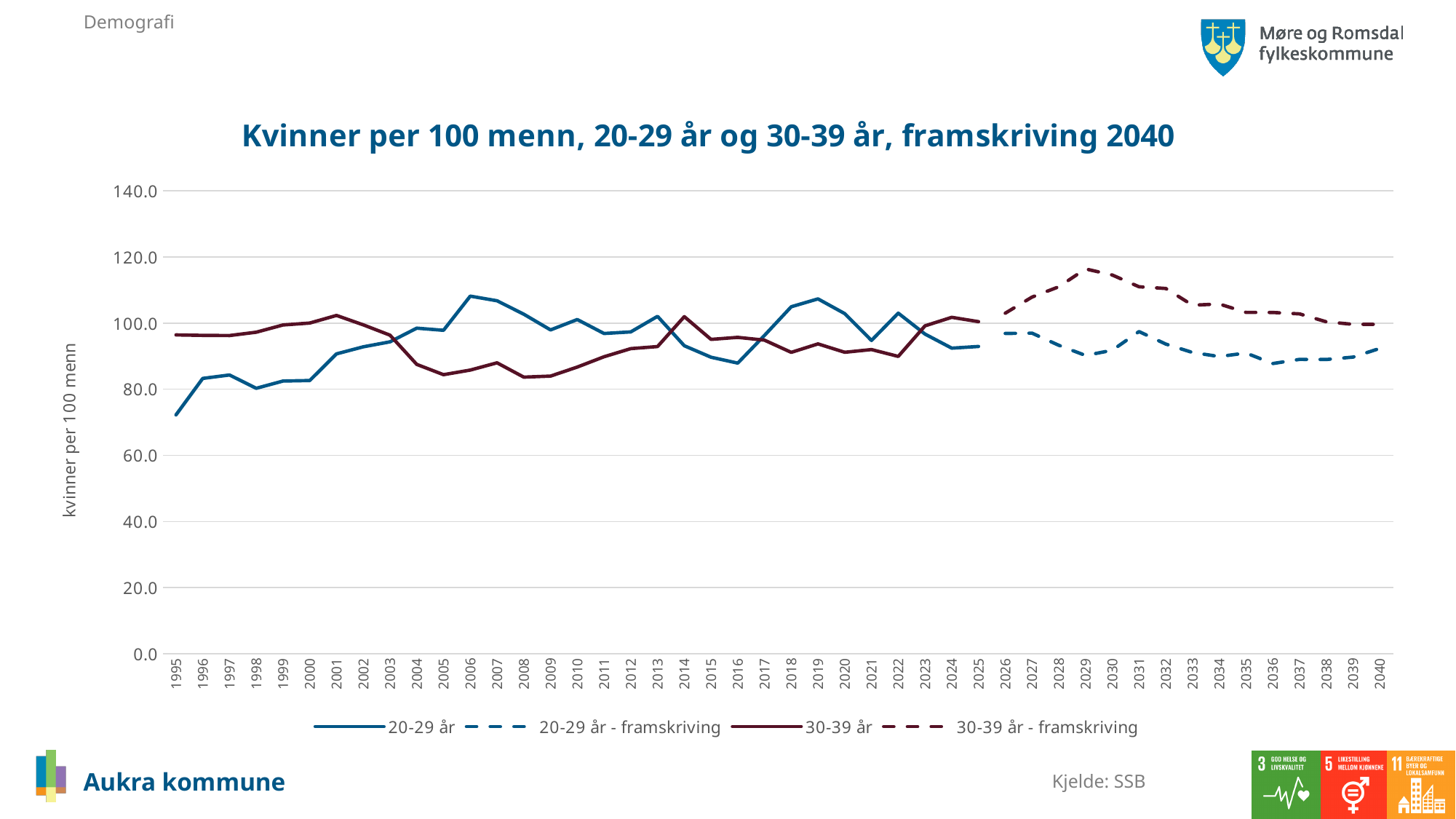
How many series does the legend list? 4 Is the value for 30-39 år - framskriving in 2029 greater or less than 100? greater How many years are shown along the x axis? 46 In which year does the 30-39 år - framskriving series reach its highest value? 2029 In 2029, which series has the larger value: 20-29 år - framskriving or 30-39 år - framskriving? 30-39 år - framskriving Is the value for 30-39 år in 2005 greater or less than 100? less Is the value for 20-29 år in 1995 greater or less than 80? less What kind of chart is shown on the slide? line chart In which year is the 20-29 år series at its lowest value? 1995 What is the label on the y axis? kvinner per 100 menn In 1995, which series has the larger value: 20-29 år or 30-39 år? 30-39 år